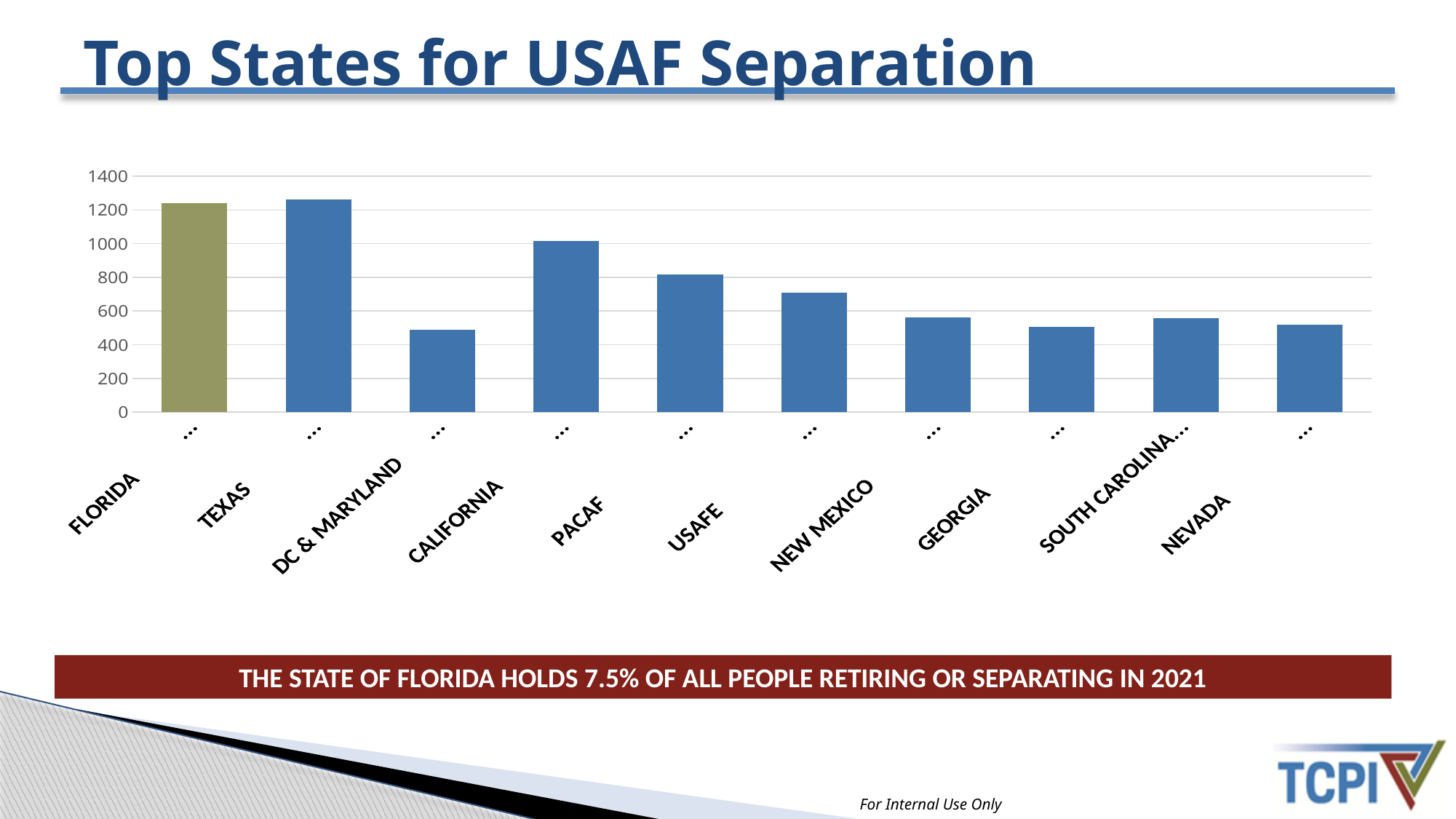
What kind of chart is shown on the slide? bar chart Is the value for USAFE greater or less than 600? greater What is the title of the slide? Top States for USAF Separation Which is larger, the value for Florida or the value for California? Florida Is the value for Florida greater or less than 1200? greater Which is larger, the value for USAFE or the value for New Mexico? USAFE How many states or regions are shown on the chart? 10 Which bar is shown in a different colour from the others? Florida Which is larger, the value for PACAF or the value for USAFE? PACAF Is the value for California greater or less than 1200? less